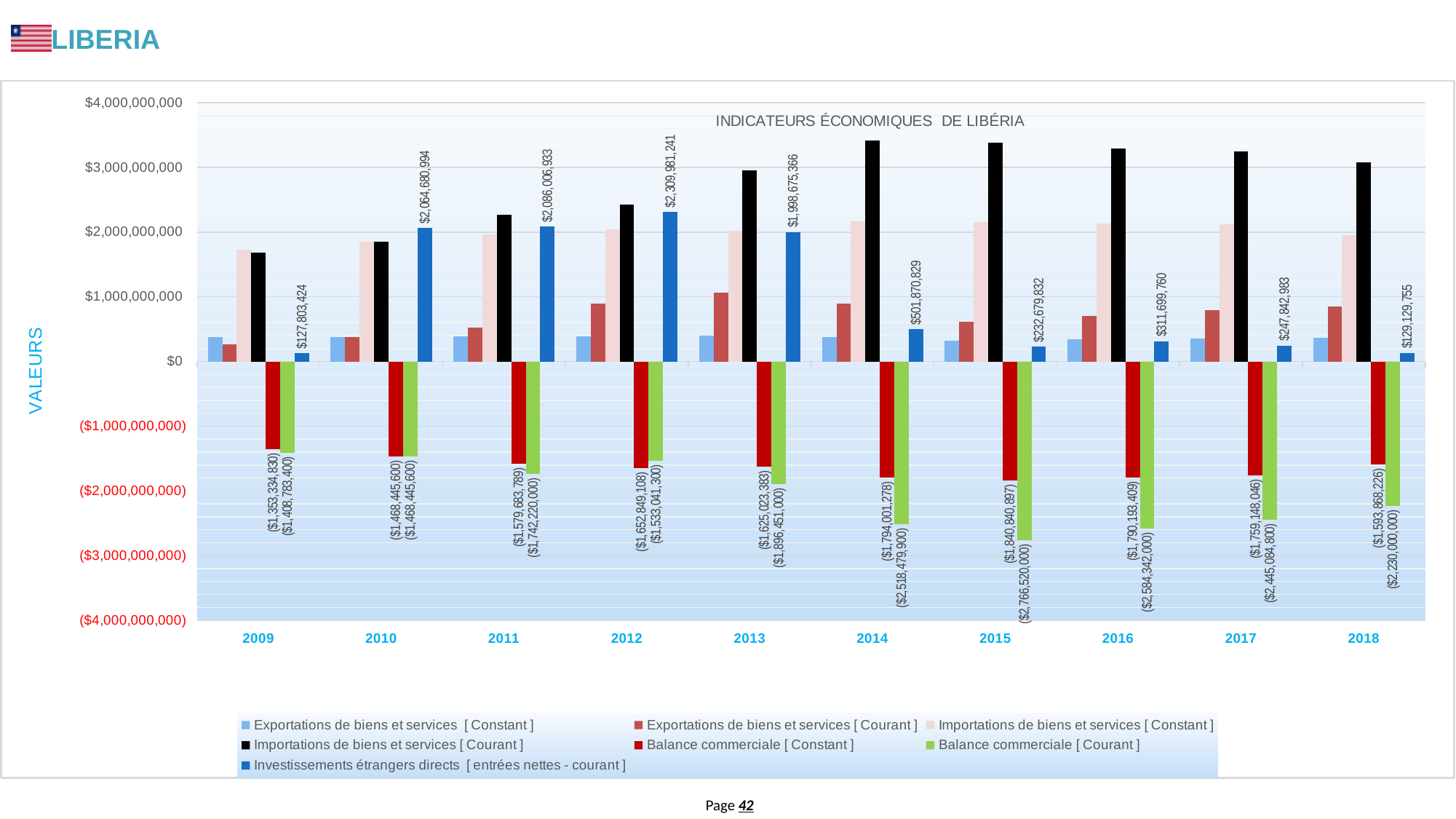
What is the value of Investissements étrangers directs [entrées nettes - courant] in 2012? $2,309,981,241 What is the title of the chart? INDICATEURS ÉCONOMIQUES DE LIBÉRIA What kind of chart is shown on the slide? Bar chart What is the difference between Investissements étrangers directs in 2011 and in 2010? $21,325,939 Does Importations de biens et services [Courant] rise or fall from 2009 to 2014? rise How many series does the legend list? 7 What is the value of Balance commerciale [Courant] in 2015? ($2,766,520,000) Is the value for Importations de biens et services [Courant] in 2014 greater or less than $3,000,000,000? greater Which year has the larger value for Importations de biens et services [Courant], 2009 or 2014? 2014 In which year is Investissements étrangers directs [entrées nettes - courant] highest? 2012 In which year is Investissements étrangers directs [entrées nettes - courant] lowest? 2009 How many years are shown on the x axis? 10